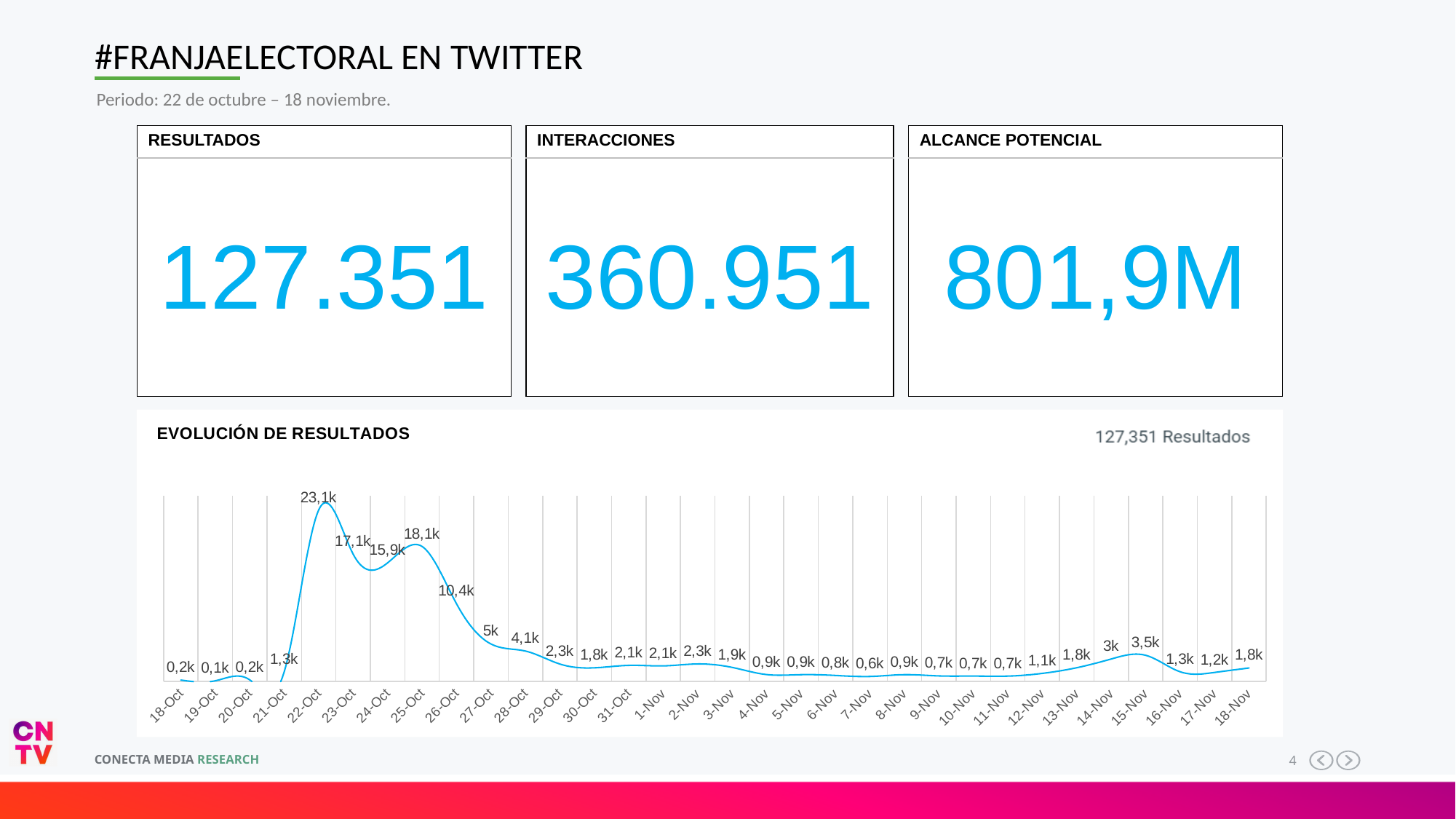
What kind of chart is shown under 'EVOLUCIÓN DE RESULTADOS'? line chart In the 'EVOLUCIÓN DE RESULTADOS' chart, what is the value for 15-Nov? 3,5k In the 'EVOLUCIÓN DE RESULTADOS' chart, do the values rise or fall from 11-Nov to 15-Nov? rise In the 'EVOLUCIÓN DE RESULTADOS' chart, which is larger, the value for 23-Oct or the value for 25-Oct? 25-Oct In the 'EVOLUCIÓN DE RESULTADOS' chart, which date has the highest value? 22-Oct What total number of results is shown at the top right of the 'EVOLUCIÓN DE RESULTADOS' chart? 127,351 Resultados In the 'EVOLUCIÓN DE RESULTADOS' chart, what is the value for 26-Oct? 10,4k In the 'EVOLUCIÓN DE RESULTADOS' chart, do the values rise or fall from 25-Oct to 30-Oct? fall In the 'EVOLUCIÓN DE RESULTADOS' chart, which date has the lowest value? 19-Oct In the 'EVOLUCIÓN DE RESULTADOS' chart, what is the value for 22-Oct? 23,1k How many dates are plotted on the x axis of the 'EVOLUCIÓN DE RESULTADOS' chart? 32 In the 'EVOLUCIÓN DE RESULTADOS' chart, what is the difference between the values for 22-Oct and 25-Oct? 5k